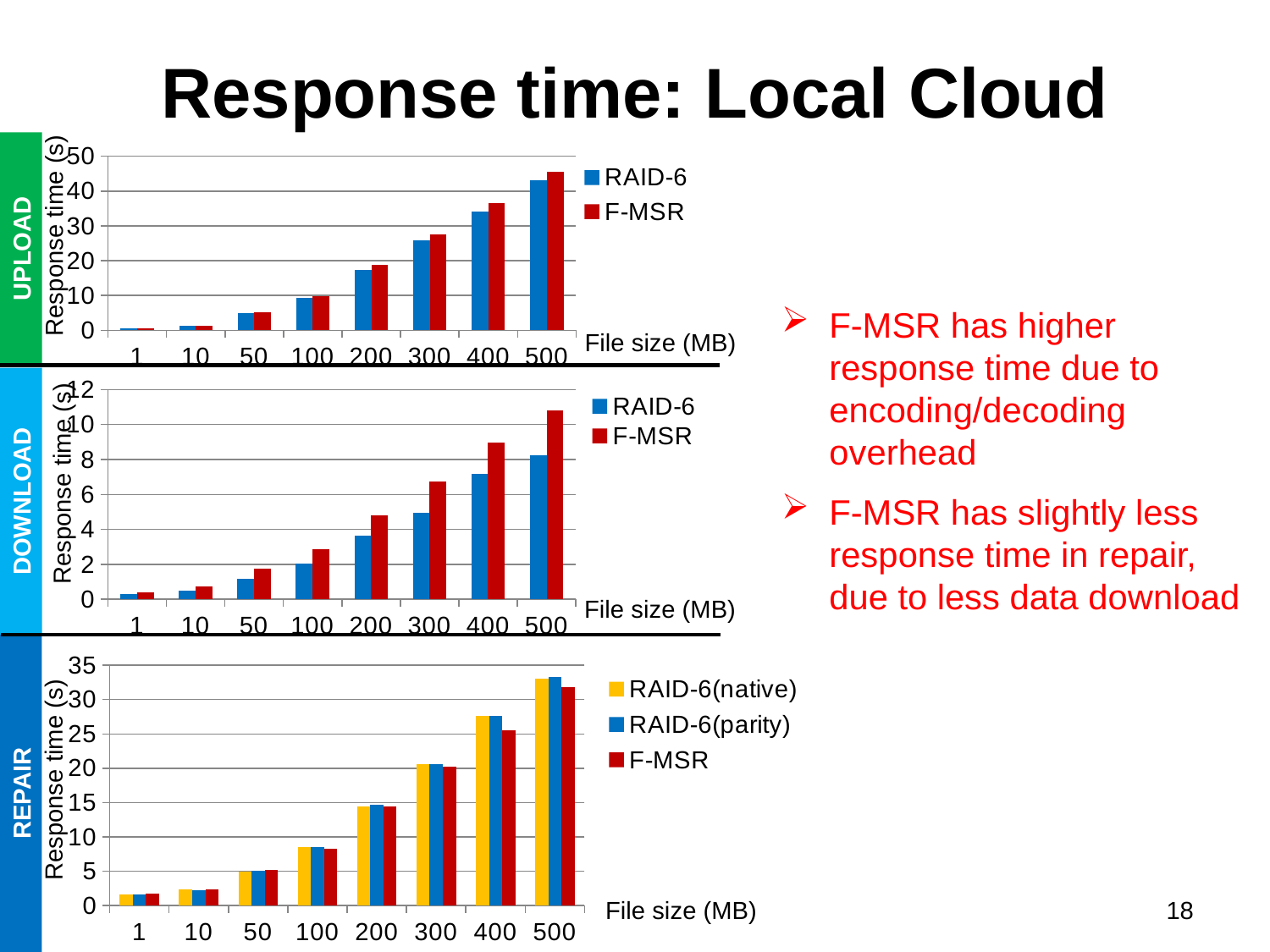
In the REPAIR chart, which series has the larger value at file size 400, RAID-6(native) or F-MSR? RAID-6(native) What kind of chart is the UPLOAD chart? bar chart How many series does the legend of the REPAIR chart list? 3 How many file size categories are shown on the x axis of the DOWNLOAD chart? 8 In the DOWNLOAD chart, is the RAID-6 value for file size 400 greater or less than 8? less In the DOWNLOAD chart, which series has the larger value at file size 500, RAID-6 or F-MSR? F-MSR In the DOWNLOAD chart, is the F-MSR value for file size 500 greater or less than 10? greater In the REPAIR chart, is the F-MSR value for file size 400 greater or less than 30? less In the UPLOAD chart, at which file size is the F-MSR response time highest? 500 In the REPAIR chart, do the response times rise or fall as file size increases along the x axis? rise How many series does the legend of the UPLOAD chart list? 2